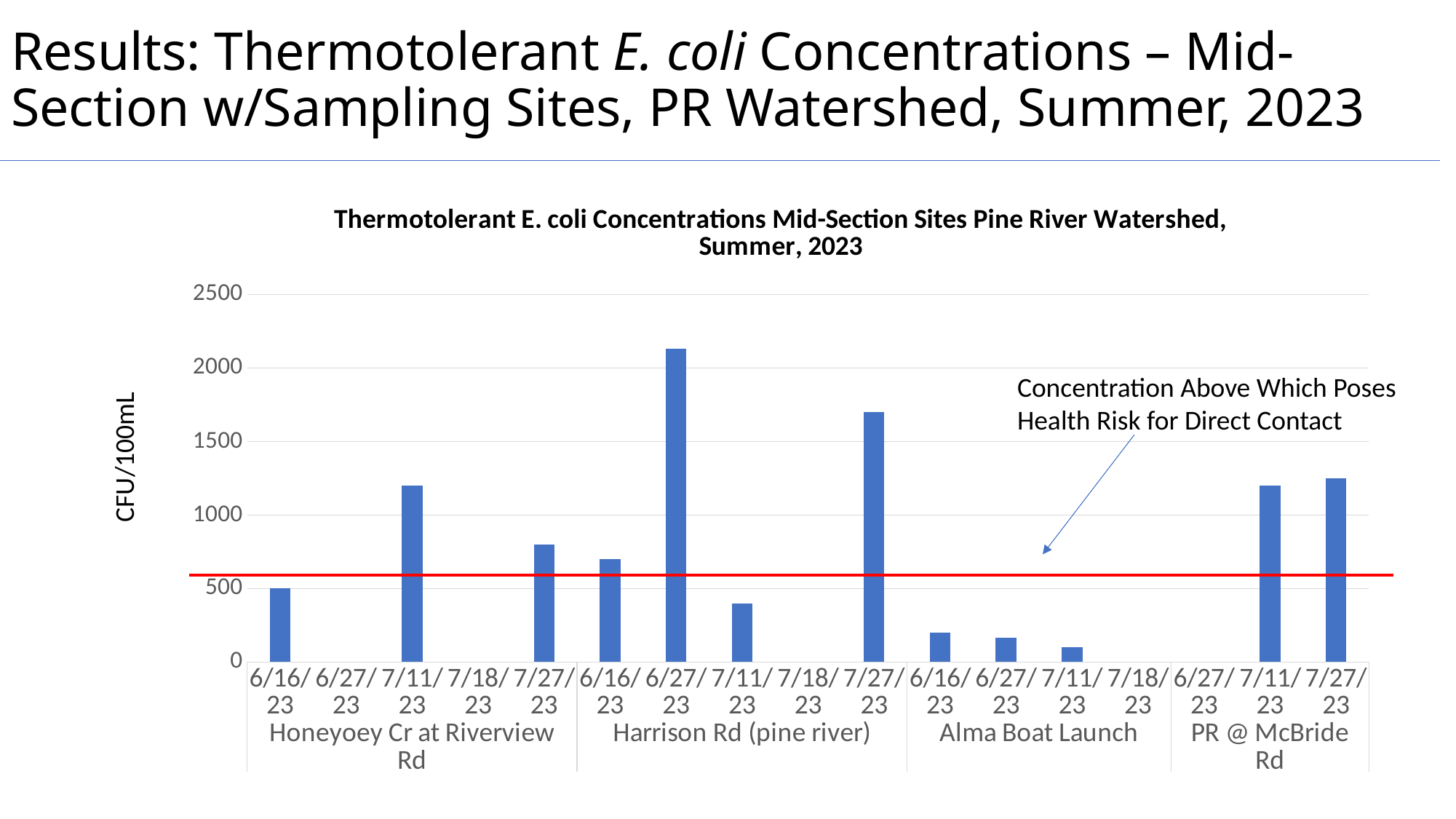
Among the bars shown, which site and date has the lowest E. coli concentration? Alma Boat Launch, 7/11/23 Which site and date has the highest E. coli concentration? Harrison Rd (pine river), 6/27/23 How many sampling sites are grouped along the x axis? 4 Is the value for Honeyoey Cr at Riverview Rd on 7/11/23 greater or less than 1000? greater Which is larger: the value for Honeyoey Cr at Riverview Rd on 7/11/23 or the value for Harrison Rd (pine river) on 7/11/23? Honeyoey Cr at Riverview Rd Is the value for Harrison Rd (pine river) on 6/27/23 greater or less than 2000? greater Is the value for Alma Boat Launch on 6/16/23 greater or less than 500? less What is the label on the y axis? CFU/100mL What kind of chart is shown on the slide? bar chart Which is larger: the value for Harrison Rd (pine river) on 6/27/23 or the value for Harrison Rd (pine river) on 7/27/23? 6/27/23